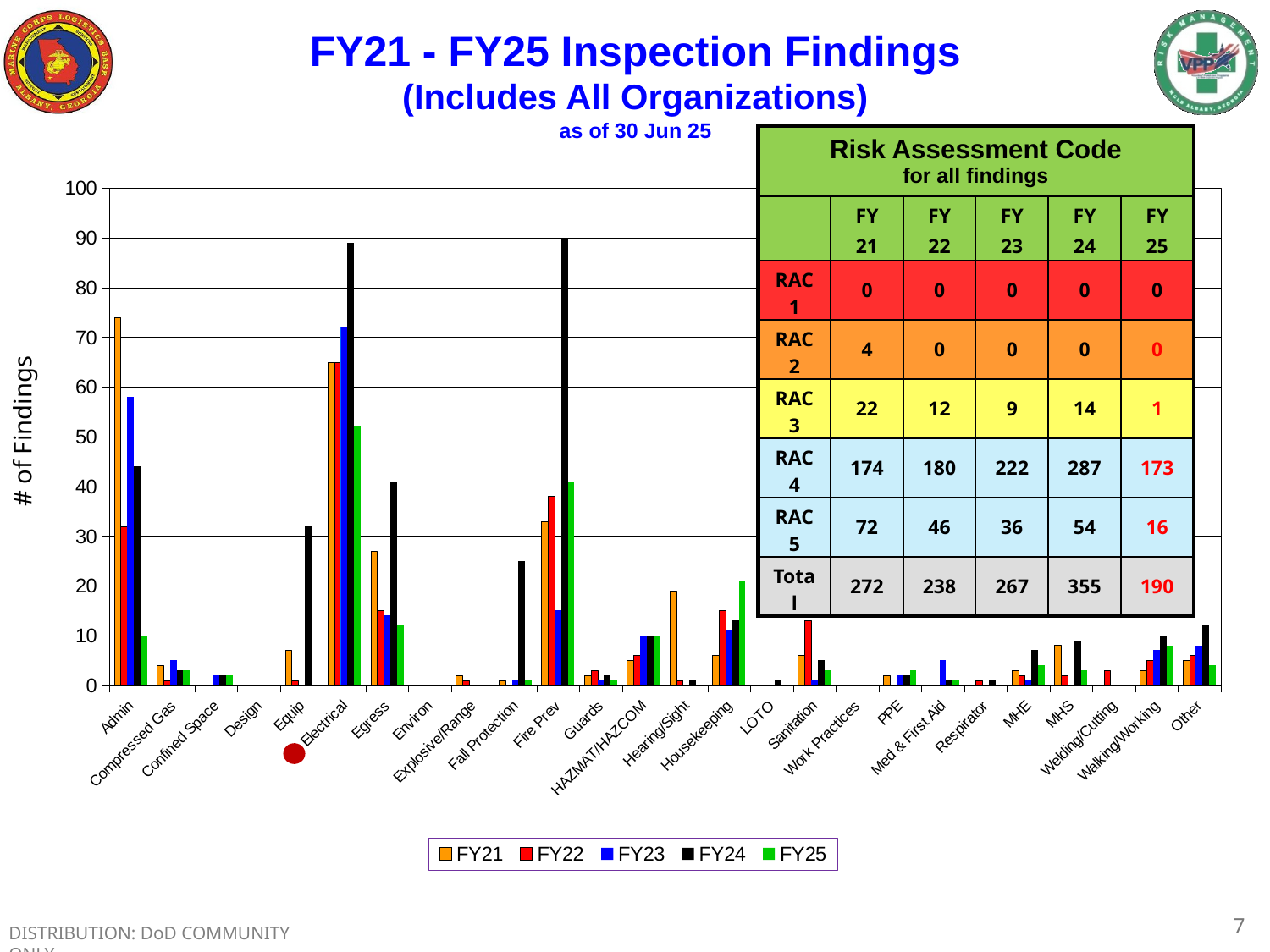
Which category has the tallest FY21 bar? Admin What is the label on the chart's vertical axis? # of Findings How many series does the chart legend list? 5 Is the FY24 value for Fall Protection greater or less than 20? greater Is the FY21 value for Admin greater or less than 70? greater What kind of chart is shown on the slide? bar chart Which category has the tallest FY23 bar? Electrical Which series has the tallest bar for Fire Prev? FY24 For Admin, which is larger, the FY21 bar or the FY22 bar? FY21 How many categories are shown along the x axis of the chart? 26 Is the FY24 value for Fire Prev greater or less than 80? greater